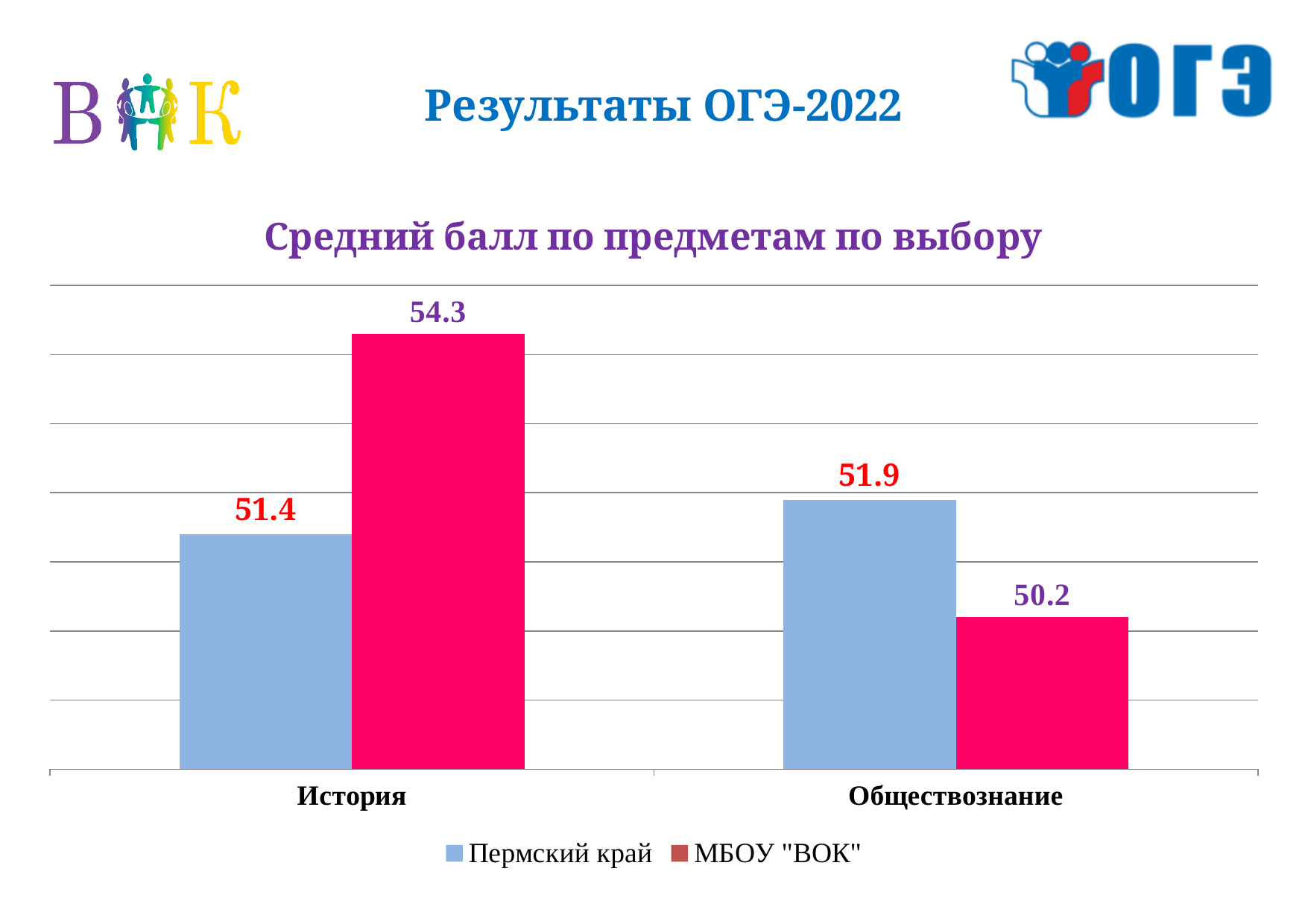
What is the difference between the Пермский край and МБОУ "ВОК" scores in Обществознание? 1.7 What is the average score for МБОУ "ВОК" in Обществознание? 50.2 What is the average score for Пермский край in История? 51.4 Which bar in the chart has the highest value? МБОУ "ВОК" in История (54.3) What type of chart is shown on the slide? Bar chart What is the average score for МБОУ "ВОК" in История? 54.3 What is the difference between the МБОУ "ВОК" and Пермский край scores in История? 2.9 How many subject categories are shown on the x axis? 2 In Обществознание, which is larger: the Пермский край score or the МБОУ "ВОК" score? Пермский край What is the average score for Пермский край in Обществознание? 51.9 Which bar in the chart has the lowest value? МБОУ "ВОК" in Обществознание (50.2) How many series does the legend list? 2